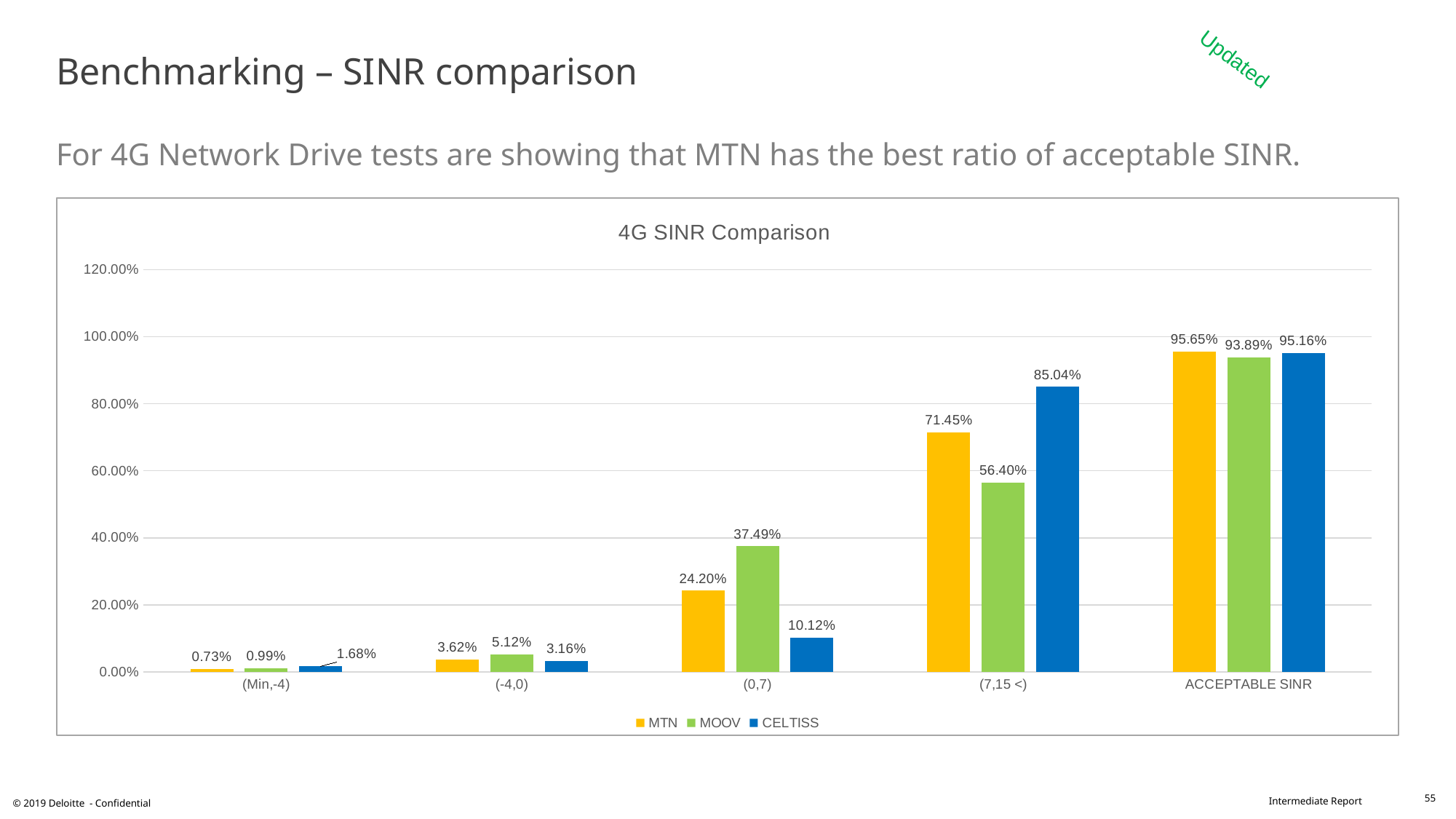
What is the value for CELTISS in the (7,15 <) category? 85.04% What is the difference between the MTN and MOOV values in the (7,15 <) category? 15.05% What is the value for MTN in the ACCEPTABLE SINR category? 95.65% What is the value for MOOV in the (0,7) category? 37.49% Is the value for MTN in the (0,7) category greater or less than 20.00%? greater Which operator has the lowest value in the (0,7) category? CELTISS What kind of chart is shown on the slide? Bar chart How many categories are shown on the x axis? 5 Which operator has the highest value in the (7,15 <) category? CELTISS Which is larger in the (-4,0) category, the MTN value or the MOOV value? MOOV How many series does the legend list? 3 What is the title of the chart? 4G SINR Comparison